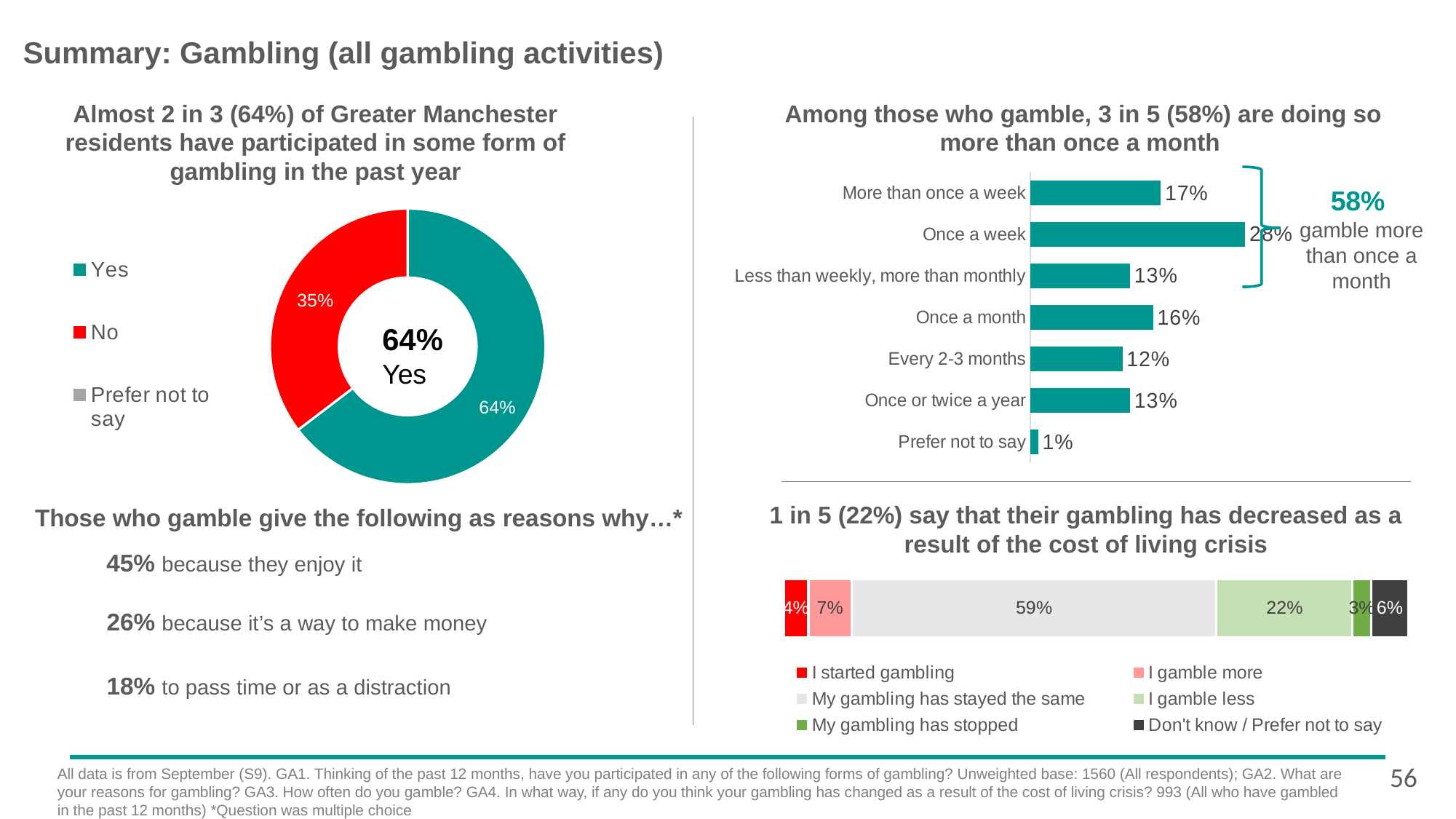
In the donut chart on the left, what percentage of Greater Manchester residents answered 'Yes' to having participated in gambling in the past year? 64% In the 'Among those who gamble' bar chart, what is the difference between 'Once a week' and 'More than once a week'? 11 percentage points In the 'Among those who gamble' bar chart, which frequency category has the highest value? Once a week How many series does the legend of the stacked bar chart about the cost of living crisis list? 6 In the donut chart on the left, what percentage answered 'No'? 35% In the stacked bar chart about the cost of living crisis, what percentage say they gamble less? 22% How many frequency categories are shown in the 'Among those who gamble' bar chart? 7 In the 'Among those who gamble' bar chart, which is larger: 'Once a month' or 'Every 2-3 months'? Once a month In the 'Among those who gamble' bar chart, what percentage gamble once a week? 28% What kind of chart is used to show whether residents have participated in gambling in the past year? Donut (pie) chart In the 'Among those who gamble' bar chart, which category has the lowest value? Prefer not to say In the stacked bar chart about the cost of living crisis, what percentage say their gambling has stayed the same? 59%